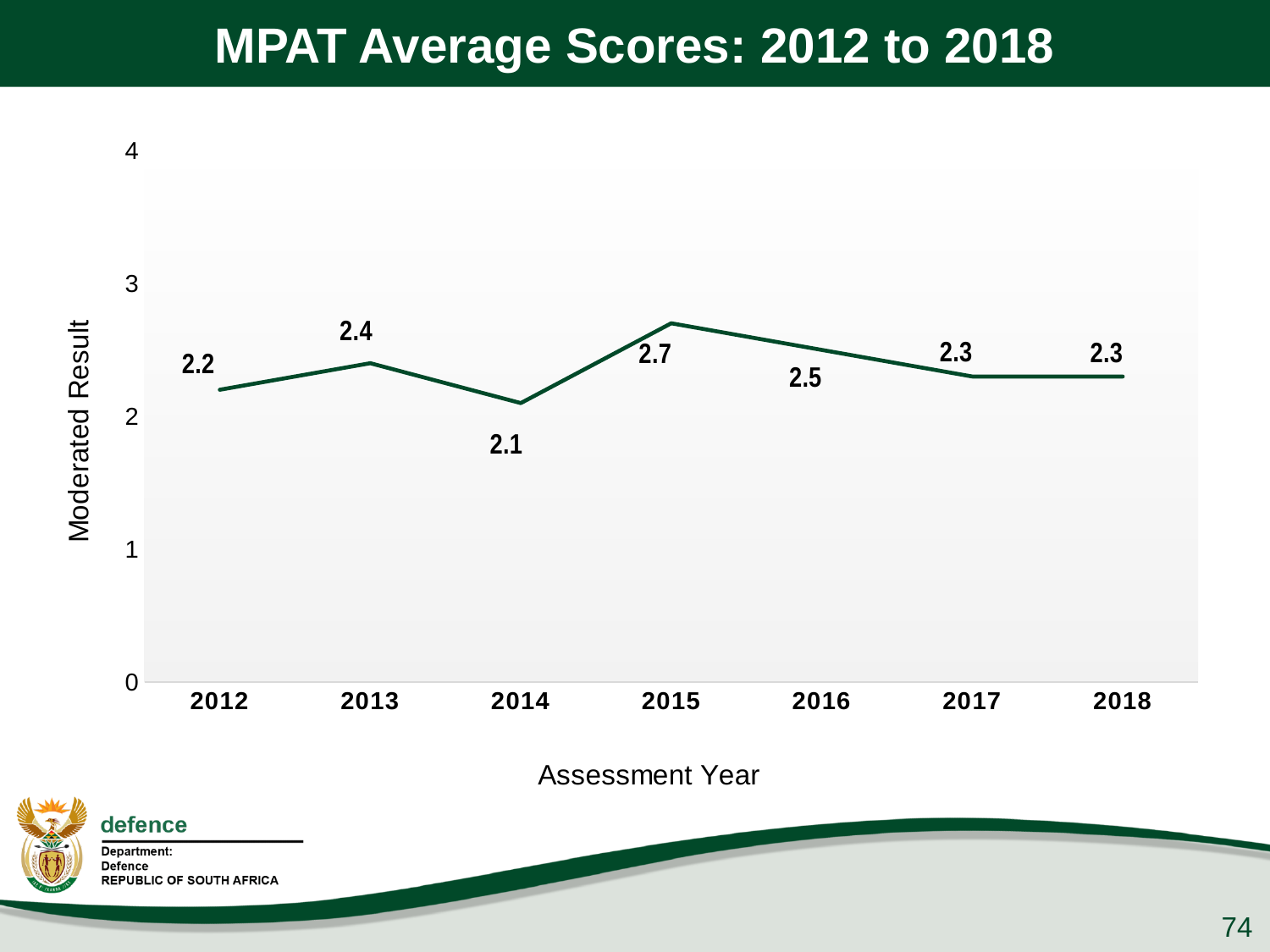
Does the moderated result rise or fall from 2015 to 2017? fall What is the moderated result for 2016? 2.5 How many assessment years are plotted on the chart? 7 Which assessment year has the lowest moderated result? 2014 What is the title of the chart? MPAT Average Scores: 2012 to 2018 Is the moderated result for 2015 greater or less than 3? less Which assessment year has the highest moderated result? 2015 What is the moderated result for 2012? 2.2 Which year has a higher moderated result, 2013 or 2016? 2016 What kind of chart is shown on the slide? line chart What is the moderated result for 2015? 2.7 What is the difference between the moderated results for 2015 and 2014? 0.6